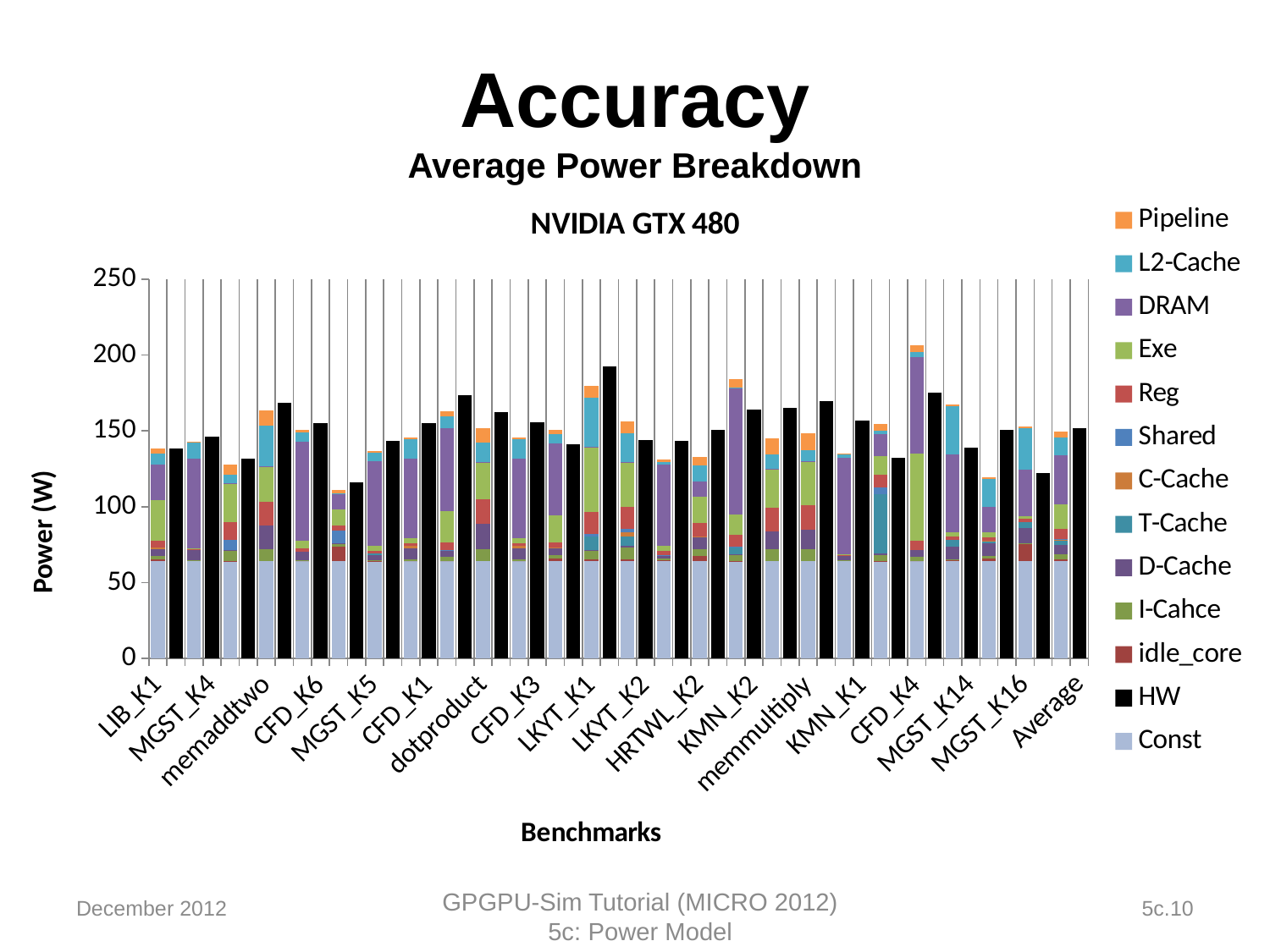
How many series does the legend list? 13 Is the total of the stacked bar for CFD_K4 greater or less than 200? greater What is the title shown above the plot area? NVIDIA GTX 480 How many benchmark categories are labelled on the x axis? 18 What is the label of the y axis? Power (W) Which benchmark has the tallest HW bar? LKYT_K1 What kind of chart is shown on the slide? Stacked bar chart Is the HW value for LKYT_K1 greater or less than 150? greater For KMN_K2, which is larger: the stacked simulated bar or the HW bar? The stacked simulated bar Which benchmark has the tallest stacked (simulated) bar? CFD_K4 Is the HW value for MGST_K5 greater or less than 150? less